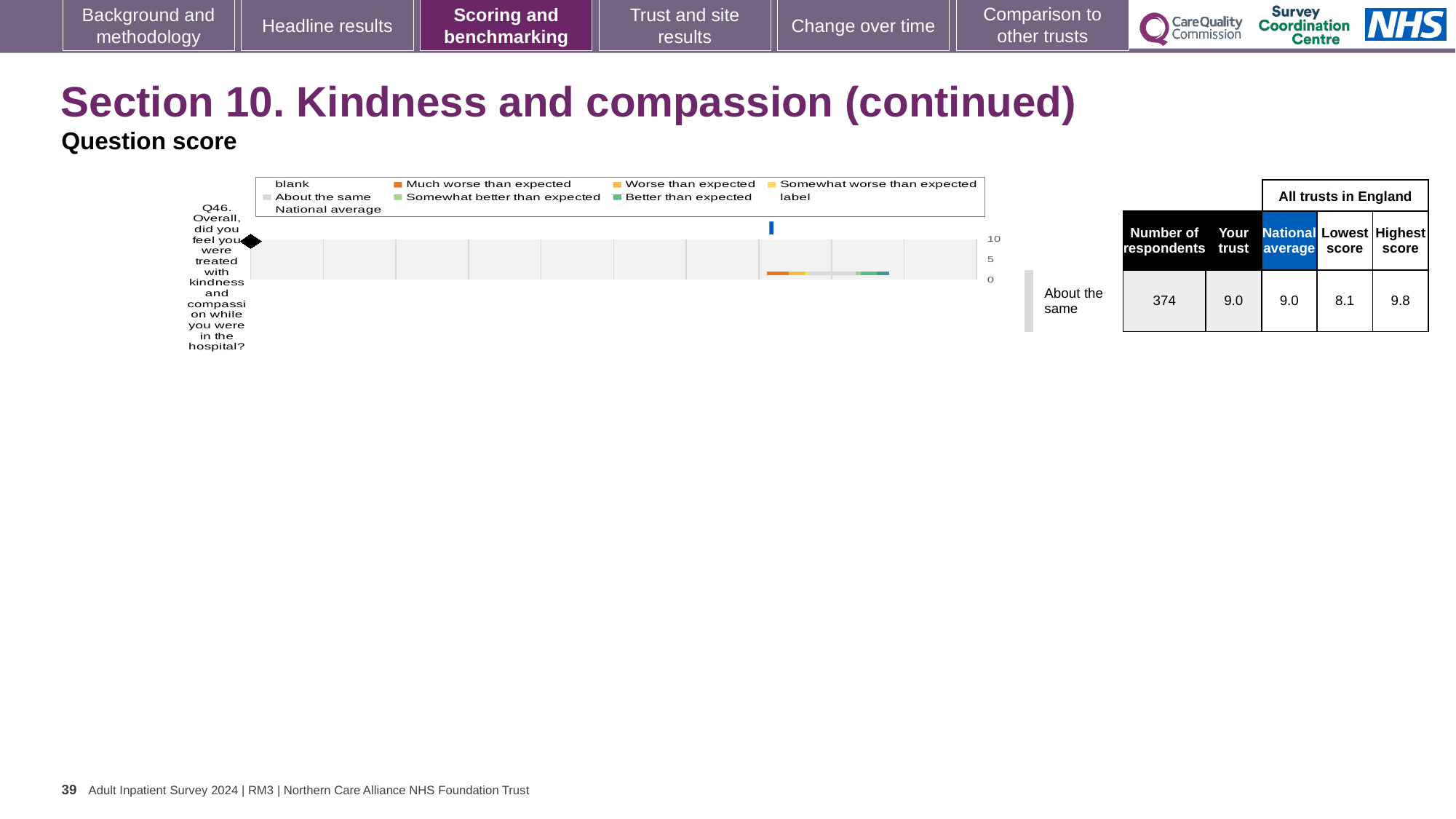
What is the highest tick value shown on the chart's score axis? 10 What is the highest score among all trusts in England for Q46? 9.8 Is the trust's score for Q46 higher than, lower than, or the same as the national average? the same Which legend entry is shown in orange? Much worse than expected What kind of chart is shown on the slide? bar chart How many respondents answered Q46? 374 What is the national average score for Q46? 9.0 What is the 'Your trust' score for Q46? 9.0 What is the lowest score among all trusts in England for Q46? 8.1 Which benchmark category is the trust's Q46 result assigned to? About the same What is the difference between the highest and lowest scores for Q46 across all trusts in England? 1.7 How many questions are plotted on the chart? 1